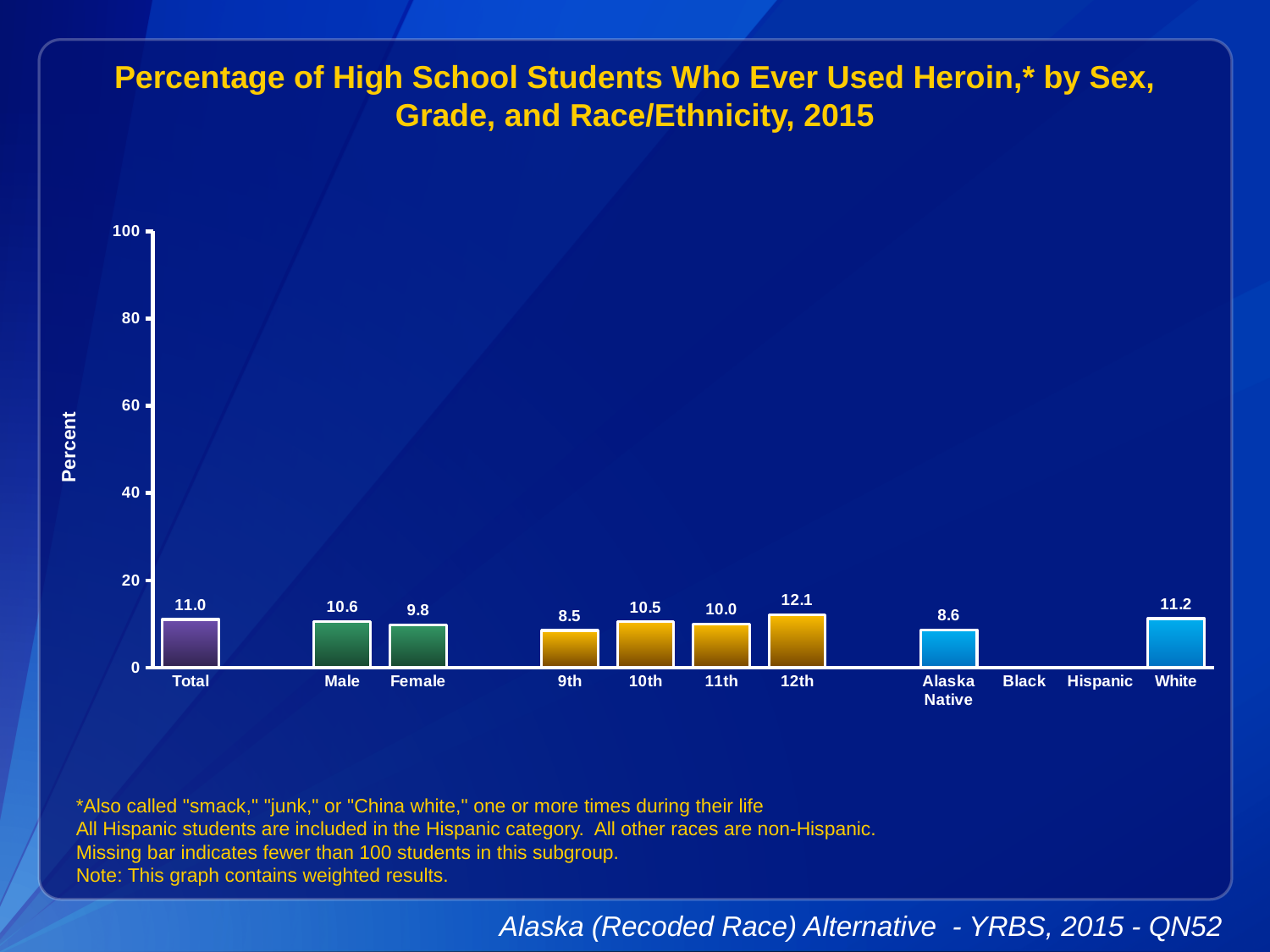
What is the value for Female? 9.8 What is the label on the y axis? Percent Which category has the highest value? 12th Which is larger, the value for 10th grade or the value for 11th grade? 10th What is the value for 12th grade? 12.1 How many categories have a bar plotted? 9 Is the value for White greater or less than 20? less Which category has the lowest value among the bars shown? 9th What is the value for Alaska Native? 8.6 What is the difference between the Male and Female values? 0.8 What kind of chart is shown? bar chart What is the value for Total? 11.0